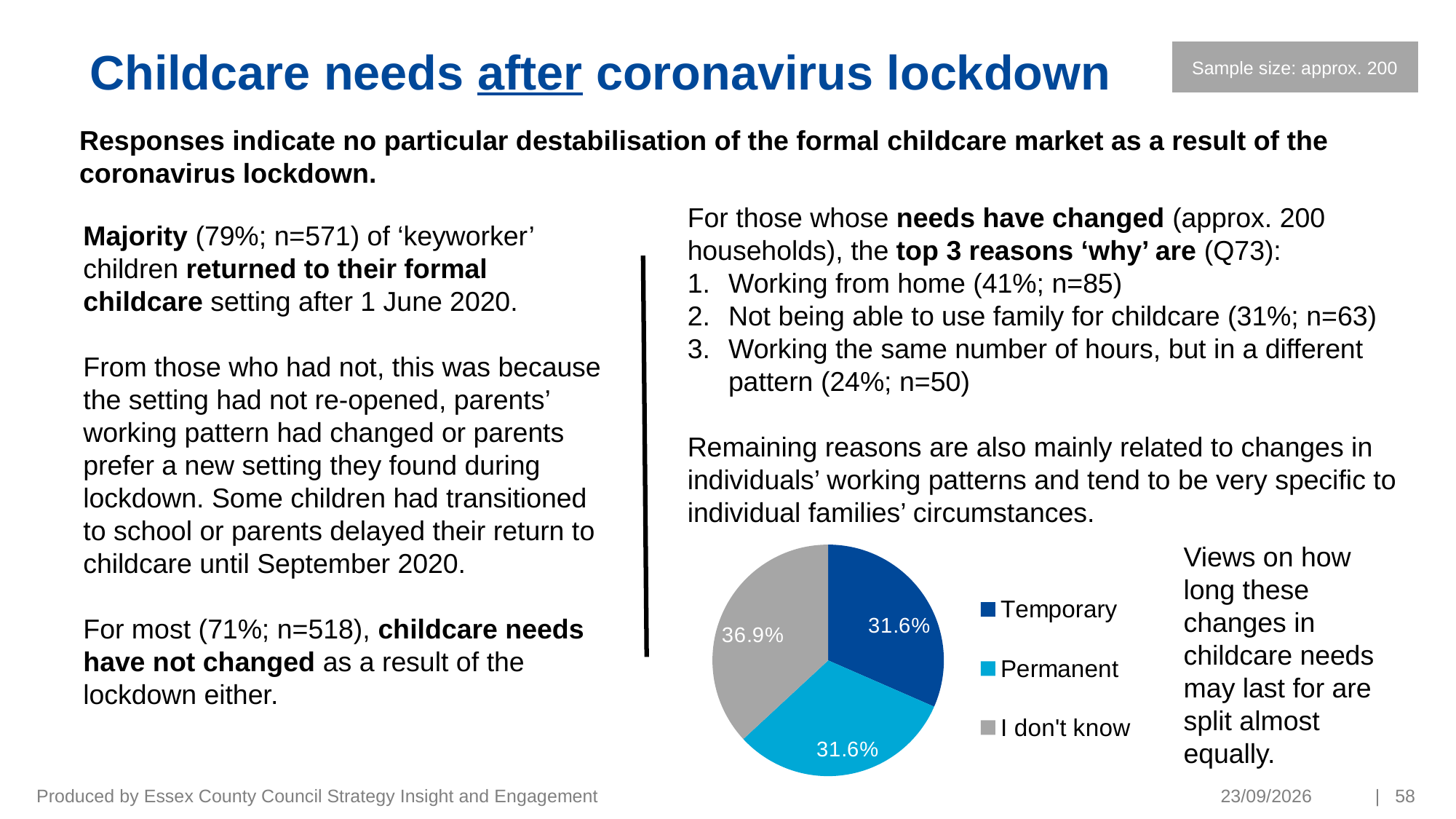
How many slices does the pie chart have? 3 Which legend entry is shown in dark blue? Temporary What colour is the 'I don't know' slice in the pie chart? Grey How many entries does the pie chart's legend list? 3 What share of the pie chart is labelled 'Permanent'? 31.6% What share of the pie chart is labelled 'Temporary'? 31.6% What kind of chart is shown on the slide? Pie chart What share of the pie chart is labelled 'I don't know'? 36.9% Which is larger in the pie chart, 'I don't know' or 'Temporary'? I don't know Which slice of the pie chart is the largest? I don't know What is the difference in percentage points between the 'I don't know' slice and the 'Permanent' slice? 5.3 Is the 'I don't know' slice greater or less than 35%? greater